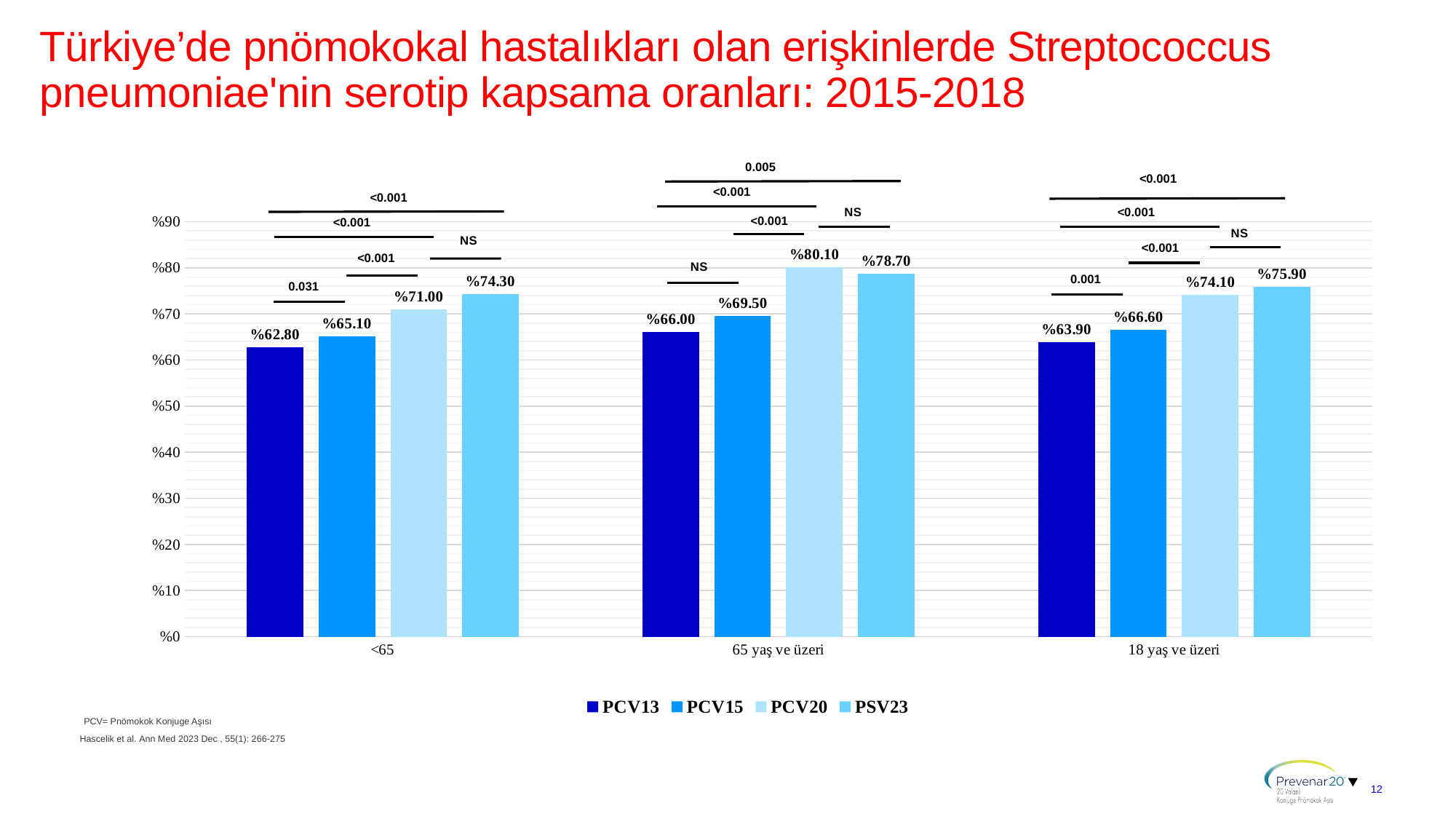
How many age groups are shown on the x axis? 3 In the 65 yaş ve üzeri group, which is larger: PCV20 or PSV23? PCV20 What kind of chart is shown on the slide? bar chart Which series is shown in the darkest blue colour in the legend? PCV13 Which series has the lowest value in the 18 yaş ve üzeri group? PCV13 What is the value for PCV20 in the 65 yaş ve üzeri group? %80.10 What is the value for PSV23 in the 18 yaş ve üzeri group? %75.90 What is the difference between the PSV23 and PCV13 values in the <65 group? %11.50 What is the value for PCV13 in the <65 group? %62.80 Which series has the highest value in the 65 yaş ve üzeri group? PCV20 How many series does the legend list? 4 Is the value for PCV13 in the 65 yaş ve üzeri group greater or less than %70? less